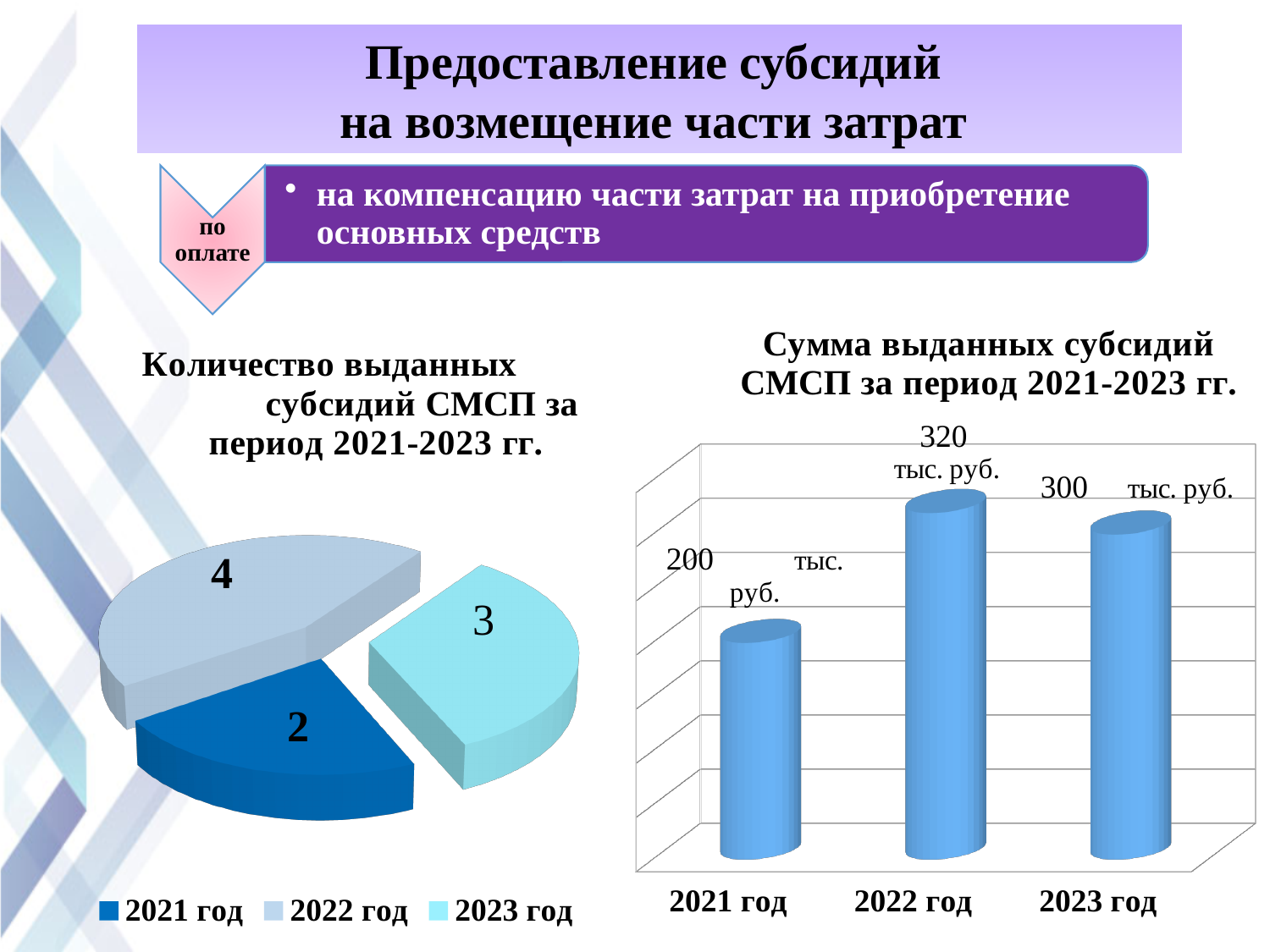
In the pie chart 'Количество выданных субсидий СМСП за период 2021-2023 гг.', how many subsidies were issued in 2022 год? 4 What kind of chart is 'Сумма выданных субсидий СМСП за период 2021-2023 гг.'? bar chart In the pie chart 'Количество выданных субсидий СМСП за период 2021-2023 гг.', which year has the smallest slice? 2021 год In the bar chart 'Сумма выданных субсидий СМСП за период 2021-2023 гг.', what is the difference between the values for 2022 год and 2023 год? 20 тыс. руб. In the pie chart 'Количество выданных субсидий СМСП за период 2021-2023 гг.', which colour represents 2023 год? light cyan In the pie chart 'Количество выданных субсидий СМСП за период 2021-2023 гг.', how many entries does the legend list? 3 In the pie chart 'Количество выданных субсидий СМСП за период 2021-2023 гг.', what is the total of all slices? 9 In the pie chart 'Количество выданных субсидий СМСП за период 2021-2023 гг.', what is the value for 2021 год? 2 In the bar chart 'Сумма выданных субсидий СМСП за период 2021-2023 гг.', what is the value for 2021 год? 200 тыс. руб. In the bar chart 'Сумма выданных субсидий СМСП за период 2021-2023 гг.', which year has the lowest value? 2021 год In the bar chart 'Сумма выданных субсидий СМСП за период 2021-2023 гг.', what is the value for 2022 год? 320 тыс. руб. In the pie chart 'Количество выданных субсидий СМСП за период 2021-2023 гг.', which year has the largest slice? 2022 год